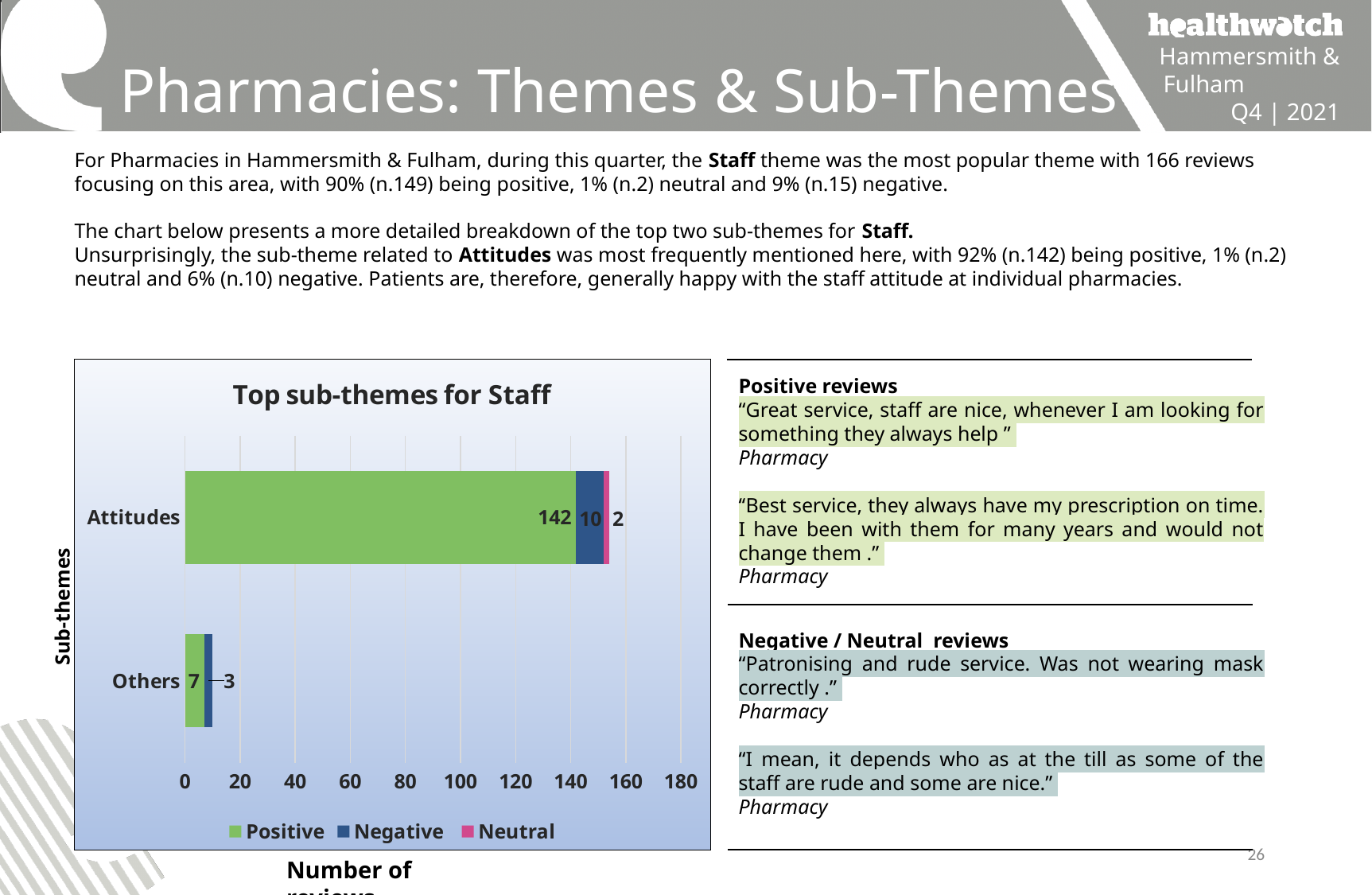
Which sub-theme has the higher number of Positive reviews? Attitudes What is the number of Positive reviews for Attitudes? 142 What is the number of Negative reviews for Others? 3 What is the difference between the Positive reviews for Attitudes and for Others? 135 What is the title of the chart? Top sub-themes for Staff What is the total number of reviews in the Attitudes bar? 154 What is the number of Negative reviews for Attitudes? 10 What is the number of Positive reviews for Others? 7 What is the number of Neutral reviews for Attitudes? 2 What type of chart is shown on the slide? Bar chart How many series does the chart legend list? 3 How many sub-theme categories are plotted on the chart? 2